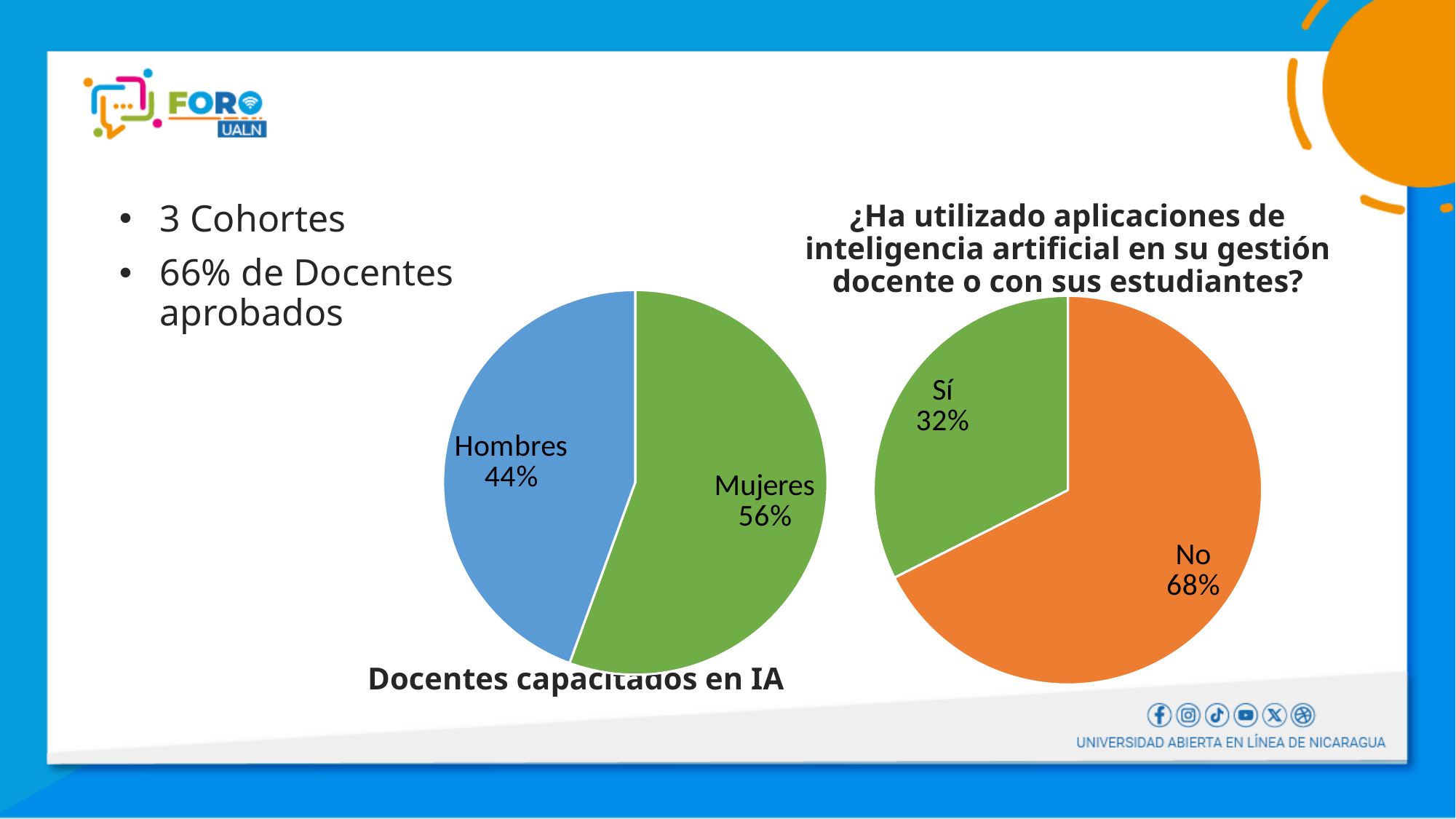
In the 'Docentes capacitados en IA' pie chart, what is the difference in percentage points between Mujeres and Hombres? 12 percentage points In the pie chart on the right, what colour is the 'No' slice? Orange In the pie chart on the right, which response has the largest share? No In the 'Docentes capacitados en IA' pie chart, what share is labelled for Hombres? 44% In the pie chart titled '¿Ha utilizado aplicaciones de inteligencia artificial en su gestión docente o con sus estudiantes?', what share answered No? 68% How many slices does the 'Docentes capacitados en IA' pie chart have? 2 In the 'Docentes capacitados en IA' pie chart, which slice is larger, Hombres or Mujeres? Mujeres In the pie chart titled '¿Ha utilizado aplicaciones de inteligencia artificial en su gestión docente o con sus estudiantes?', what share answered Sí? 32% In the 'Docentes capacitados en IA' pie chart, what share is labelled for Mujeres? 56% In the 'Docentes capacitados en IA' pie chart, what colour is the Hombres slice? Blue What kind of chart is the 'Docentes capacitados en IA' chart? Pie chart In the pie chart on the right, what is the difference in percentage points between No and Sí? 36 percentage points